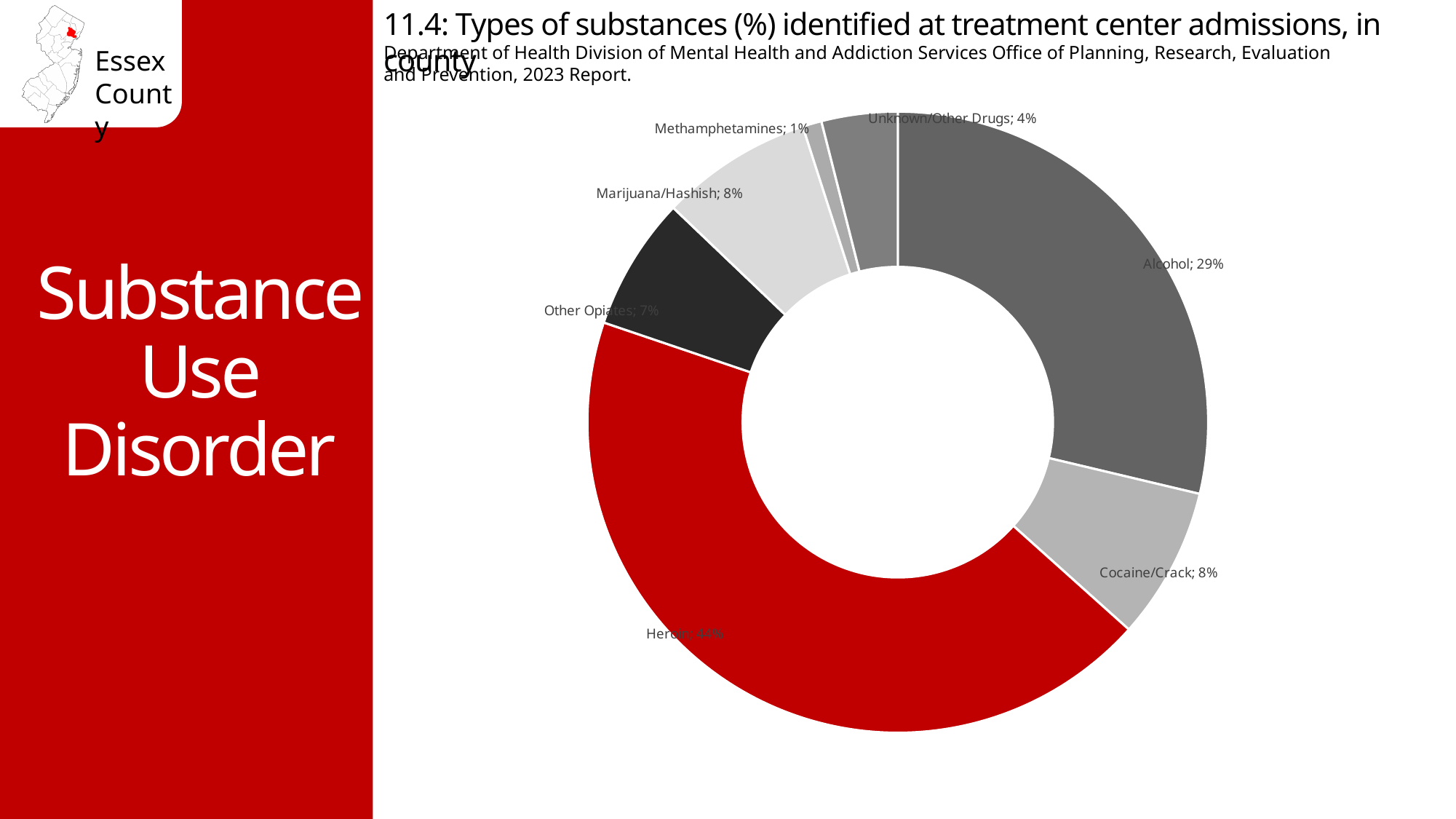
Which slice of the chart is coloured red? Heroin Which substance has the largest share in the chart? Heroin What percentage does the chart show for Alcohol? 29% What is the difference in percentage points between Heroin and Alcohol? 15 What percentage does the chart show for Other Opiates? 7% What percentage does the chart show for Methamphetamines? 1% Which has a larger share, Alcohol or Cocaine/Crack? Alcohol What kind of chart is shown on the slide? doughnut chart What percentage does the chart show for Heroin? 44% What is the combined percentage of Cocaine/Crack and Marijuana/Hashish? 16% What percentage does the chart show for Unknown/Other Drugs? 4% Which substance has the smallest share in the chart? Methamphetamines